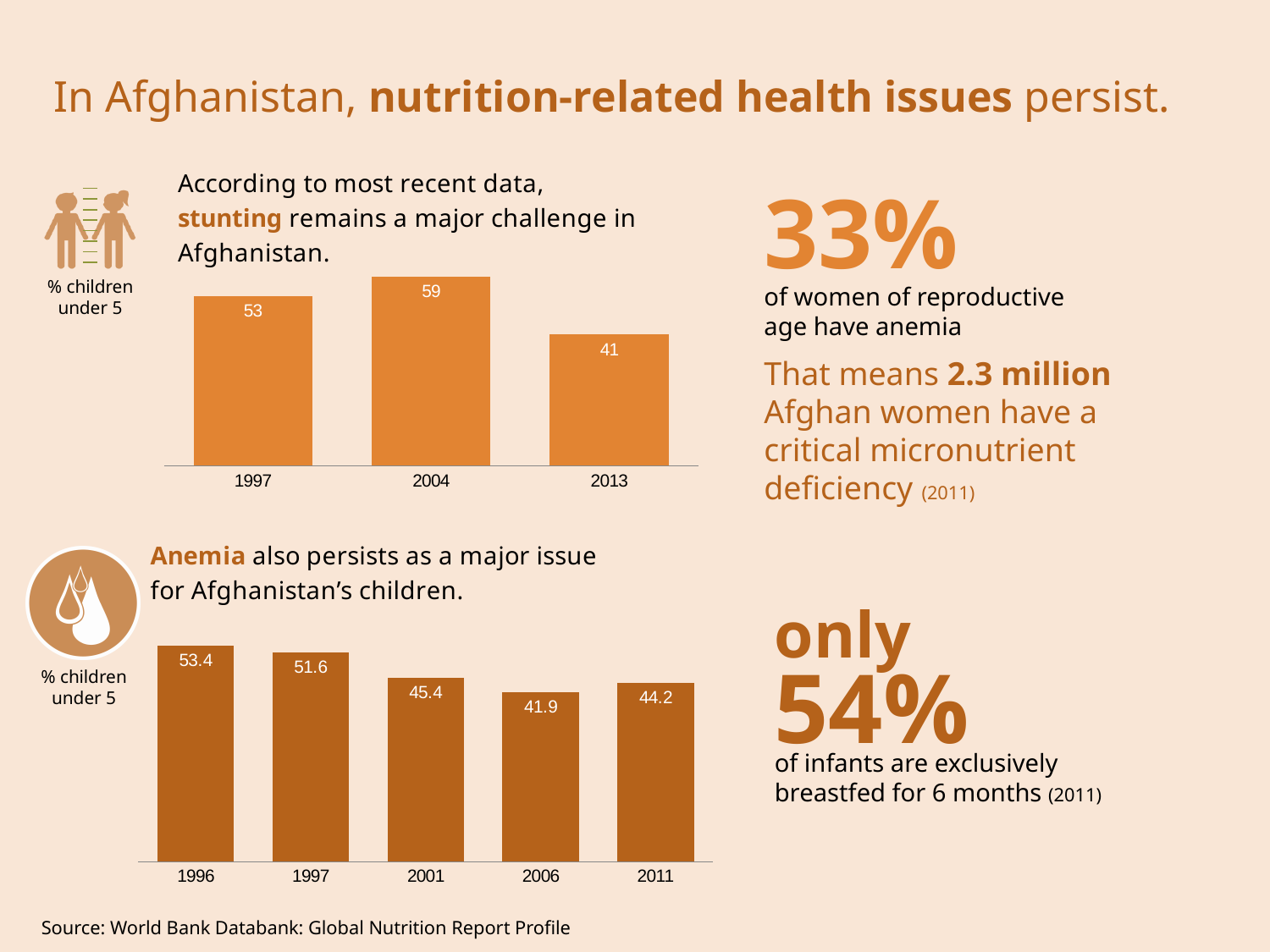
In the anemia chart (bottom), which year has the lowest value? 2006 In the anemia chart (bottom), what is the value for 2006? 41.9 In the stunting chart (top), what is the value for 2004? 59 What kind of chart is the anemia chart (bottom)? bar chart In the stunting chart (top), is the value for 1997 larger or smaller than the value for 2004? smaller In the stunting chart (top), how many years are plotted? 3 In the anemia chart (bottom), do the values generally rise or fall from 1996 to 2006? fall In the anemia chart (bottom), what is the difference between the 1996 and 2011 values? 9.2 In the anemia chart (bottom), which year has the highest value? 1996 In the stunting chart (top), what is the difference between the 2004 and 2013 values? 18 In the stunting chart (top), which year has the lowest value? 2013 In the anemia chart (bottom), how many years are plotted? 5